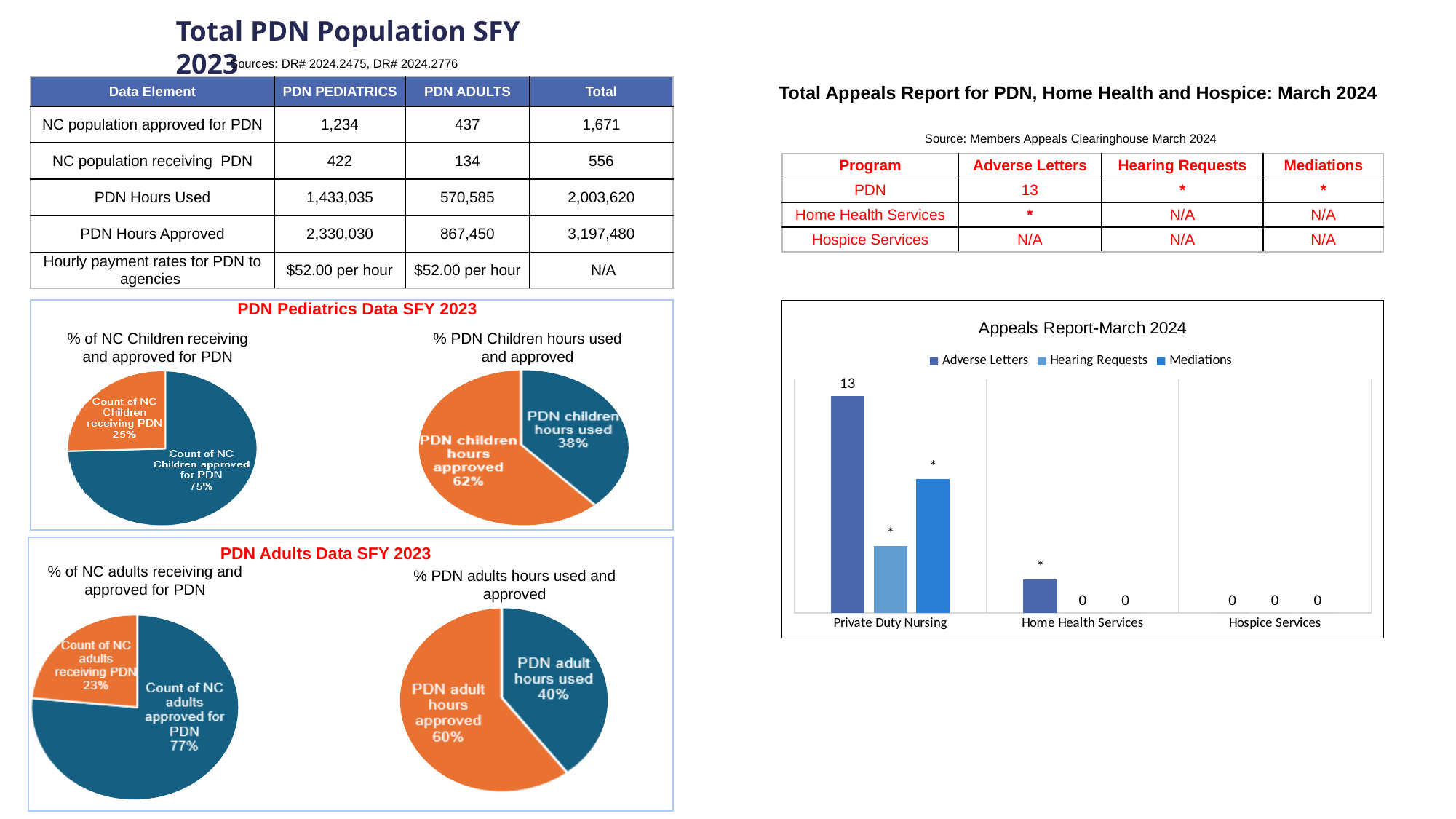
How many series does the legend of the "Appeals Report-March 2024" chart list? 3 In the "% PDN adults hours used and approved" pie chart, which slice is the largest? PDN adult hours approved In the "% of NC adults receiving and approved for PDN" pie chart, what percentage is shown for Count of NC adults receiving PDN? 23% In the "% of NC Children receiving and approved for PDN" pie chart, what share is labelled for Count of NC Children receiving PDN? 25% In the "% PDN adults hours used and approved" pie chart, what percentage is shown for PDN adult hours used? 40% What kind of chart is the "Appeals Report-March 2024" chart? bar chart In the "Appeals Report-March 2024" chart, what is the Mediations value for Hospice Services? 0 In the "Appeals Report-March 2024" chart, which category has the tallest bar? Private Duty Nursing In the "% PDN Children hours used and approved" pie chart, what percentage is shown for PDN children hours approved? 62% Is the share for PDN children hours used (in the children hours pie chart) larger or smaller than the share for PDN adult hours used (in the adults hours pie chart)? smaller How many program categories are shown on the x axis of the "Appeals Report-March 2024" chart? 3 In the "Appeals Report-March 2024" chart, what is the Adverse Letters value for Private Duty Nursing? 13